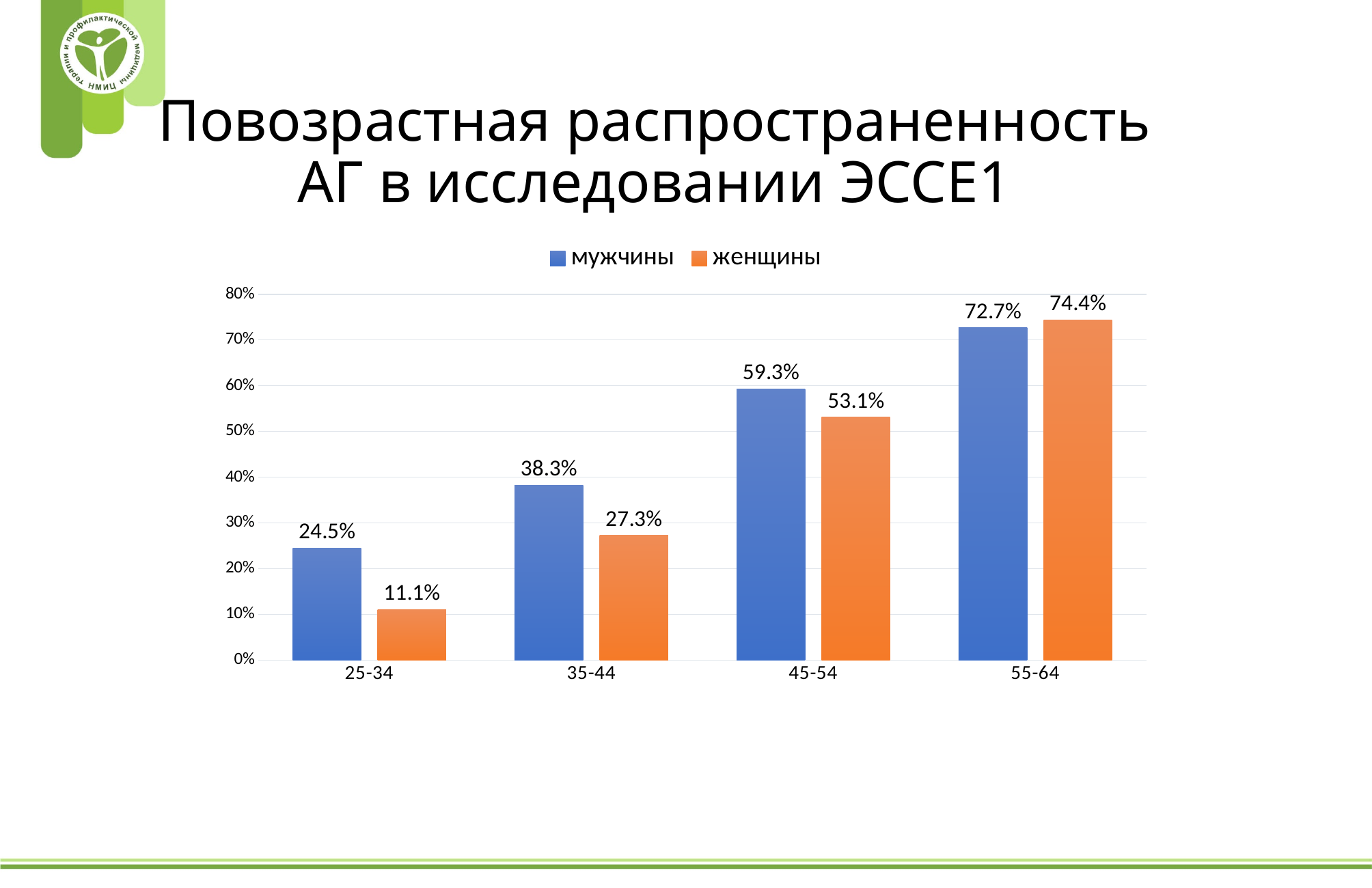
What is the value for женщины in the 55-64 age group? 74.4% What is the difference between мужчины and женщины in the 45-54 age group? 6.2% Which age group has the lowest value for женщины? 25-34 What is the value for женщины in the 45-54 age group? 53.1% Which age group has the highest value for мужчины? 55-64 What kind of chart is shown on the slide? bar chart What is the value for мужчины in the 25-34 age group? 24.5% Which is larger in the 35-44 age group, мужчины or женщины? мужчины How many series does the legend list? 2 How many age groups are shown on the x axis? 4 What is the difference between мужчины and женщины in the 25-34 age group? 13.4% Do the values for женщины rise or fall as age increases along the x axis? rise